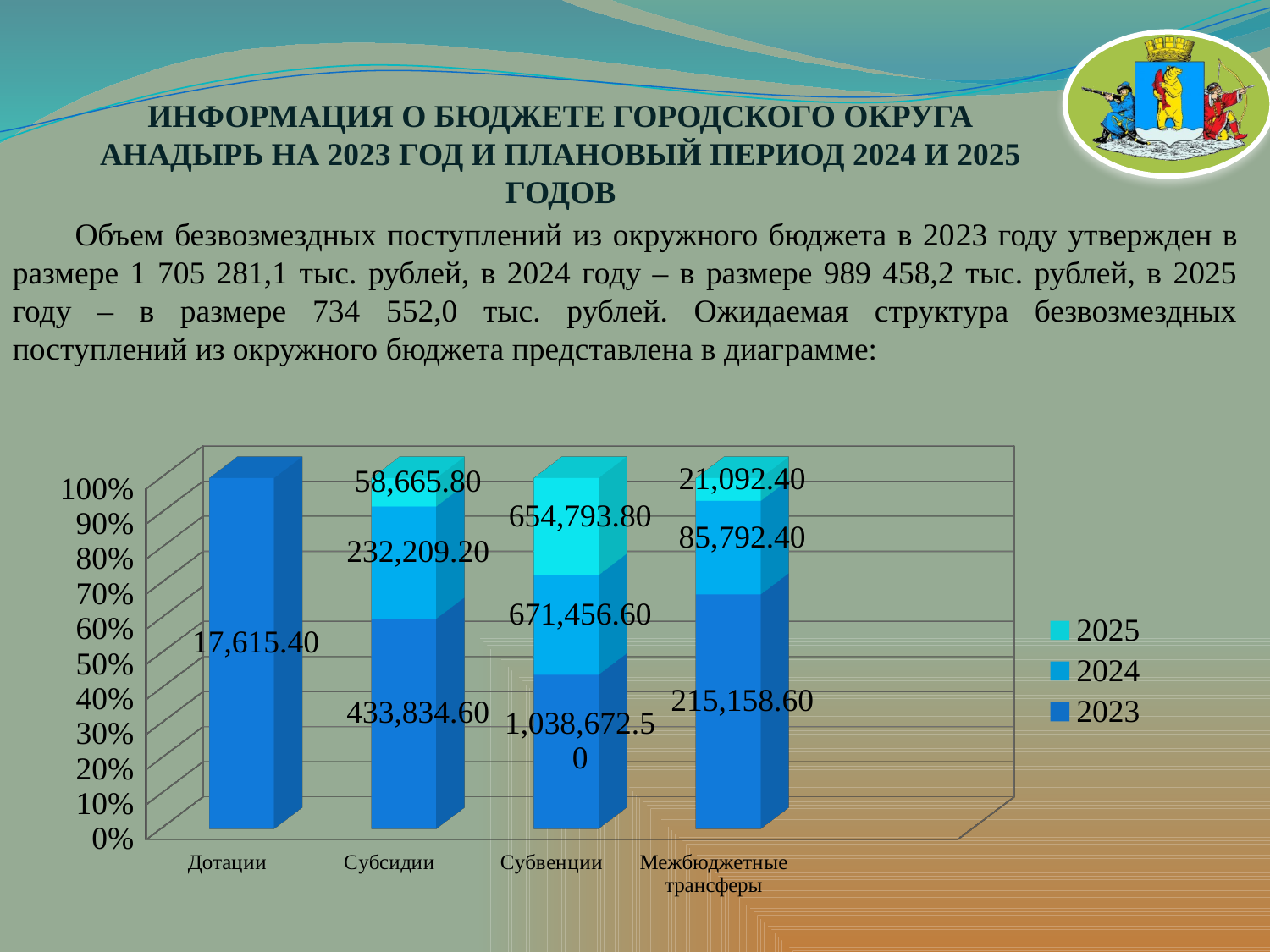
What is the total of the three labelled values in the Межбюджетные трансферы bar? 322,043.40 What kind of chart is shown on the slide? Stacked bar chart Which category has the highest 2023 value? Субвенции What is the 2025 value for Субсидии? 58,665.80 What is the 2024 value for Межбюджетные трансферы? 85,792.40 What is the 2023 value for Субвенции? 1,038,672.50 How many series does the legend list? 3 What is the difference between the 2023 and 2024 values for Субсидии? 201,625.40 Which category has the lowest 2023 value? Дотации What is the 2023 value for Дотации? 17,615.40 Which is larger: the 2024 value for Субвенции or the 2025 value for Субвенции? 2024 (671,456.60) How many categories are shown on the x axis? 4